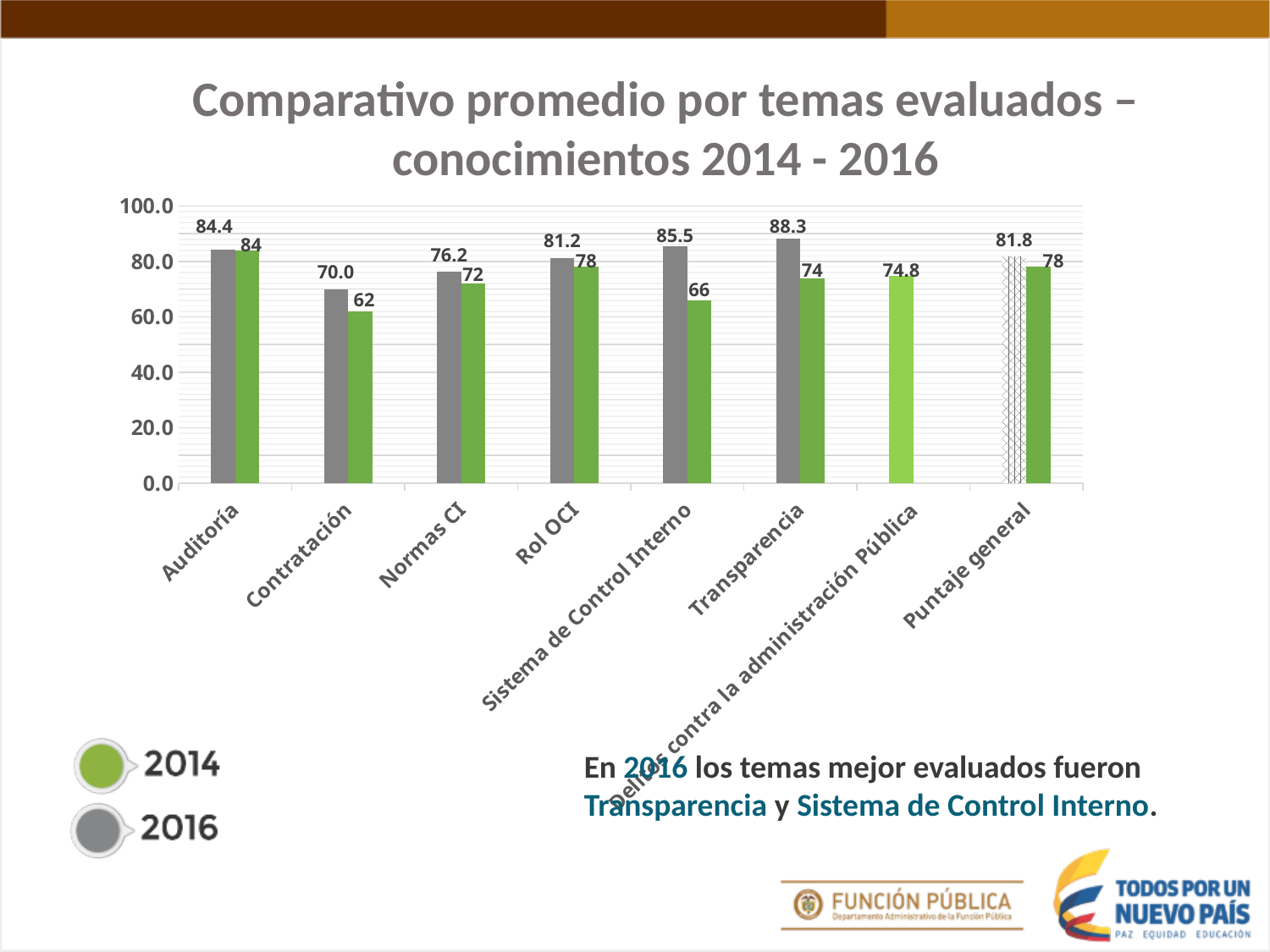
What is the difference between the 2016 and 2014 values for Sistema de Control Interno? 19.5 For Rol OCI, which year has the larger value, 2014 or 2016? 2016 What is the 2014 value for Contratación? 62 What is the 2014 value for Puntaje general? 78 Which category has the lowest 2014 value? Contratación What is the 2016 value for Transparencia? 88.3 What is the difference between the 2016 and 2014 values for Transparencia? 14.3 What kind of chart is shown on the slide? Bar chart How many categories are shown on the x axis? 8 What is the 2016 value for Sistema de Control Interno? 85.5 What value is shown for Delitos contra la administración Pública? 74.8 Which category has the highest 2016 value? Transparencia